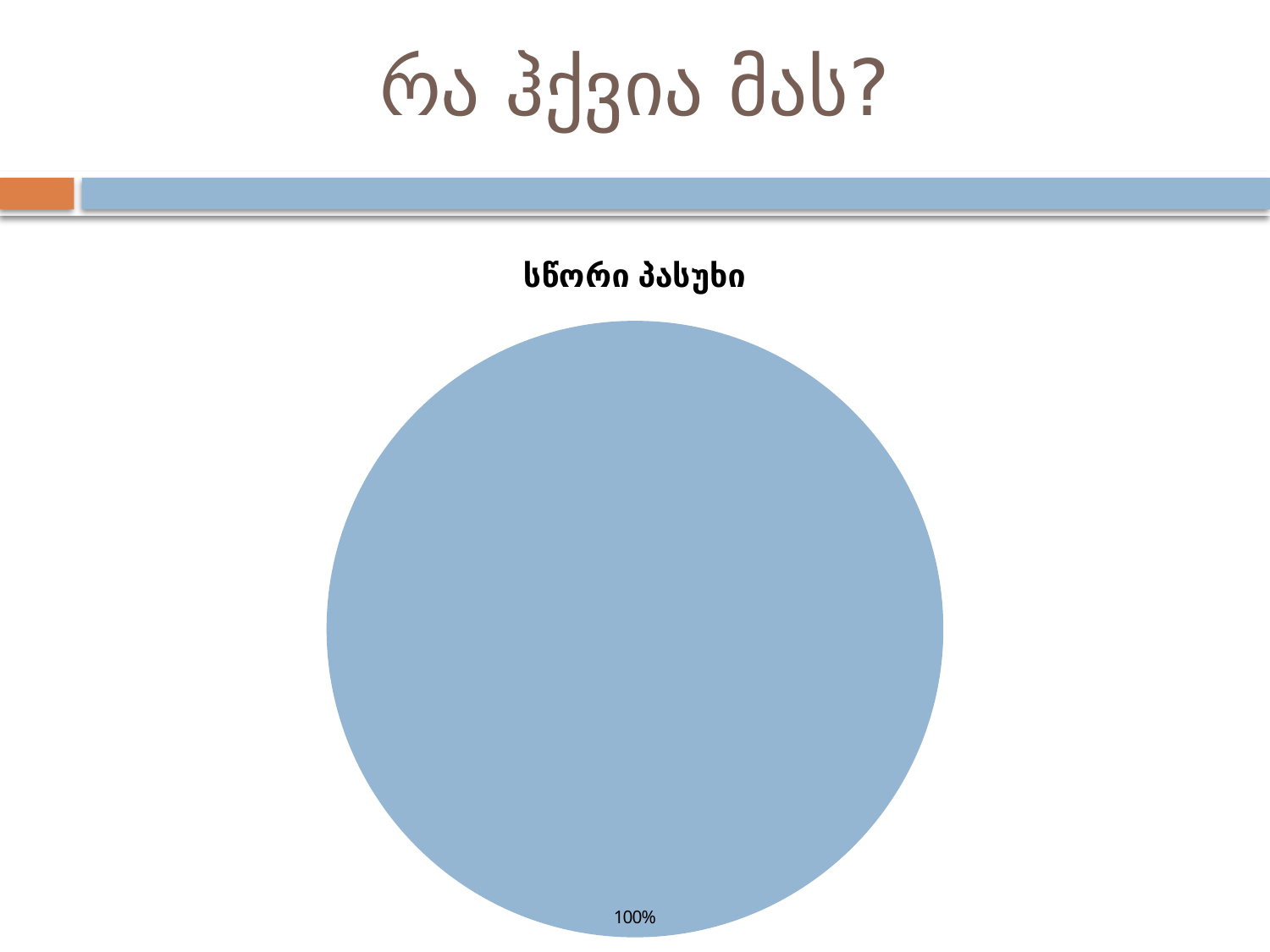
What colour is the slice of the pie chart? light blue What is the title of the pie chart? სწორი პასუხი What kind of chart is shown on the slide? pie chart What percentage is printed as the data label on the pie chart? 100% What share of the pie does the single slice represent? 100% How many slices does the pie chart contain? 1